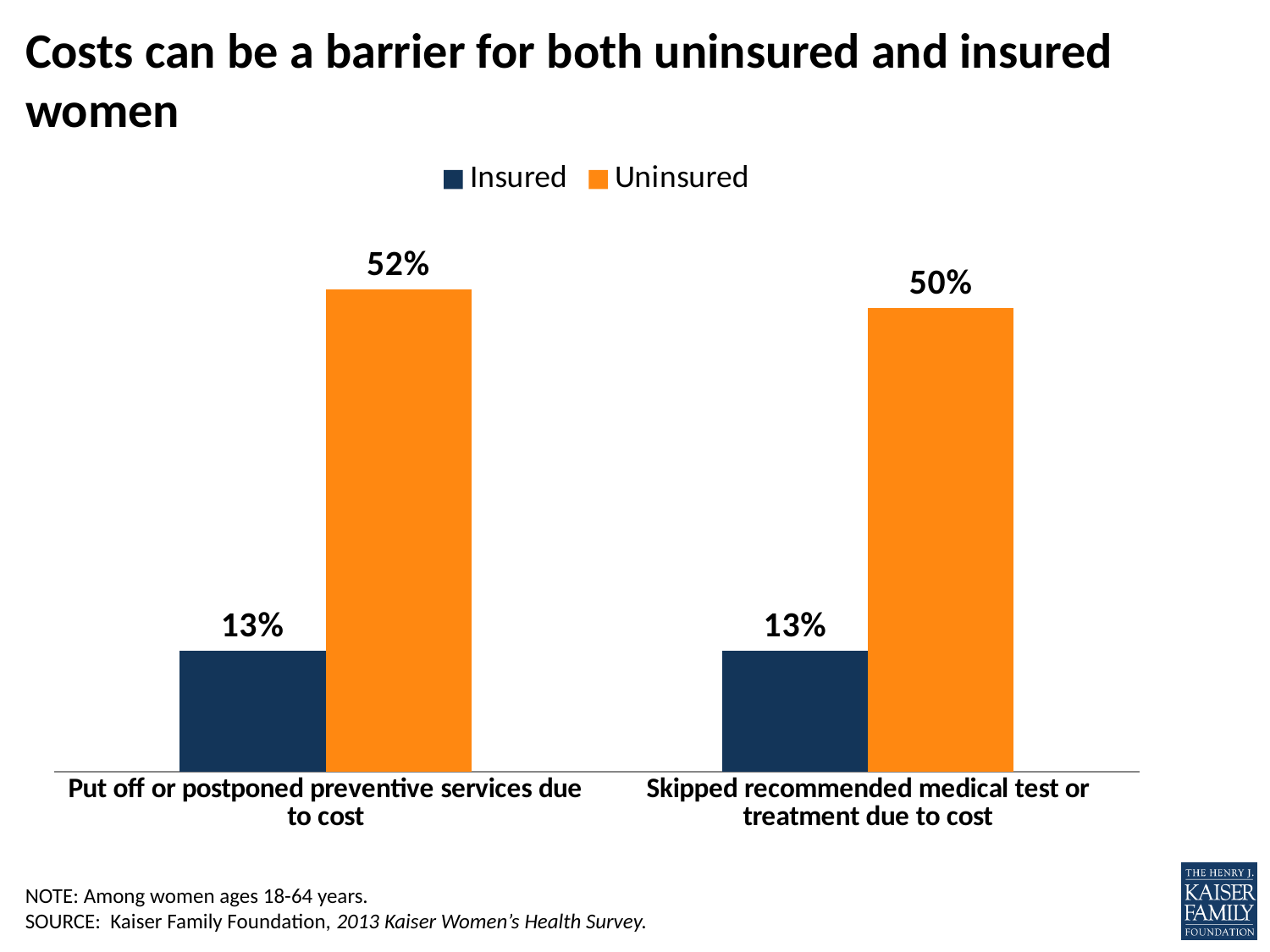
What percentage of insured women put off or postponed preventive services due to cost? 13% How many categories are shown on the x axis? 2 What is the difference between the Uninsured and Insured values for putting off or postponing preventive services due to cost? 39 percentage points Which colour represents the Uninsured series? Orange What kind of chart is shown on the slide? Bar chart What percentage of uninsured women skipped a recommended medical test or treatment due to cost? 50% What percentage of insured women skipped a recommended medical test or treatment due to cost? 13% How many series does the legend list? 2 What percentage of uninsured women put off or postponed preventive services due to cost? 52% For skipping a recommended medical test or treatment due to cost, which group has the larger value, Insured or Uninsured? Uninsured Which category has the highest value for the Uninsured series? Put off or postponed preventive services due to cost What is the difference between the Uninsured and Insured values for skipping a recommended medical test or treatment due to cost? 37 percentage points